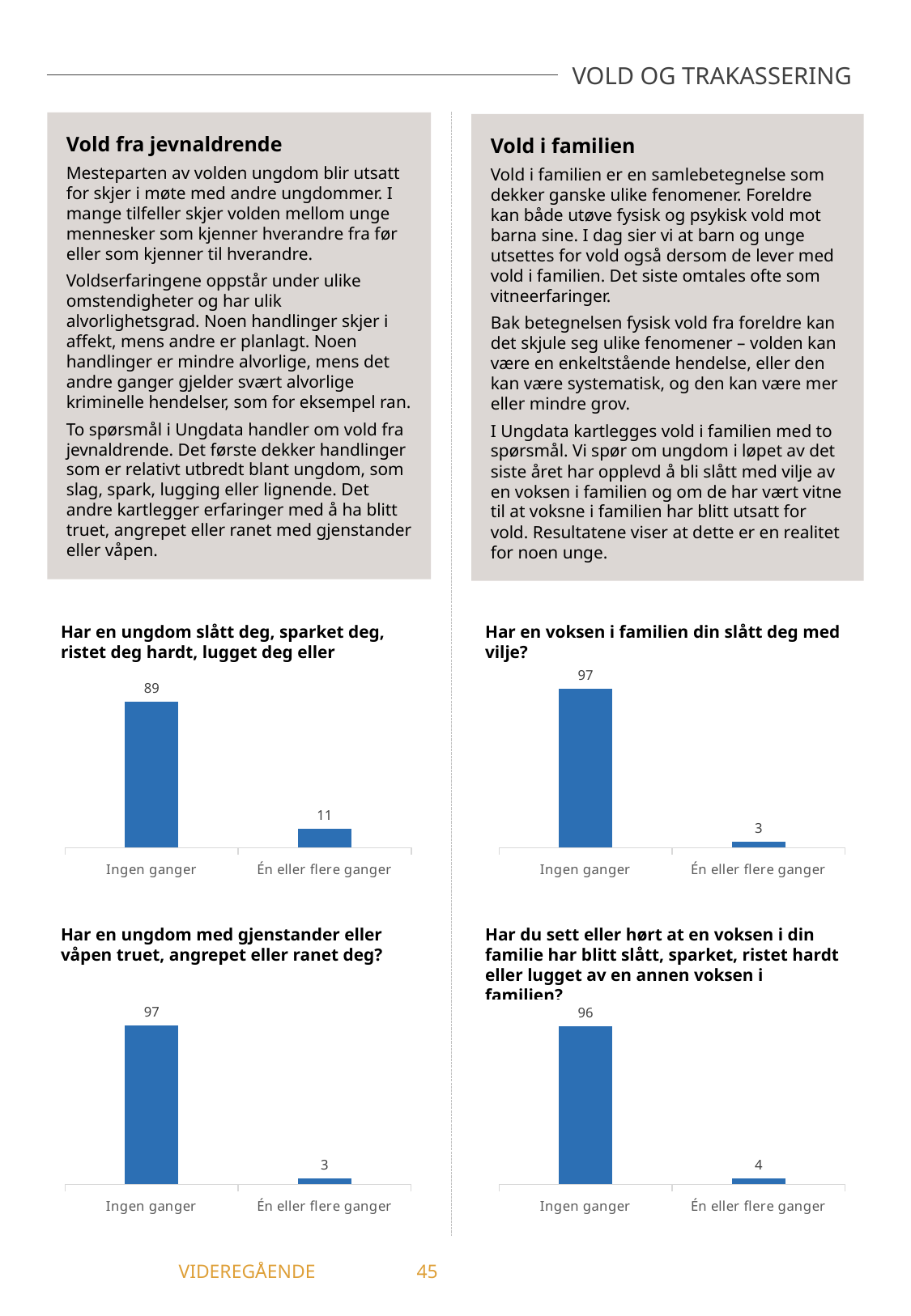
In the top-right chart ("Har en voksen i familien din slått deg med vilje?"), which category has the lowest value? Én eller flere ganger In the bottom-left chart ("Har en ungdom med gjenstander eller våpen truet, angrepet eller ranet deg?"), which category has the highest value? Ingen ganger In the top-right chart ("Har en voksen i familien din slått deg med vilje?"), what is the value for "Ingen ganger"? 97 In the top-left chart ("Har en ungdom slått deg, sparket deg..."), what is the value for "Én eller flere ganger"? 11 In the bottom-right chart ("Har du sett eller hørt at en voksen i din familie har blitt slått..."), what is the value for "Ingen ganger"? 96 In the top-left chart ("Har en ungdom slått deg, sparket deg..."), what is the difference between the values for "Ingen ganger" and "Én eller flere ganger"? 78 What type of chart is the top-left chart ("Har en ungdom slått deg, sparket deg...")? Bar chart In the bottom-right chart ("Har du sett eller hørt at en voksen i din familie har blitt slått..."), what is the value for "Én eller flere ganger"? 4 In the top-left chart ("Har en ungdom slått deg, sparket deg..."), what is the value for "Ingen ganger"? 89 In the top-right chart ("Har en voksen i familien din slått deg med vilje?"), what is the value for "Én eller flere ganger"? 3 In the bottom-left chart ("Har en ungdom med gjenstander eller våpen truet, angrepet eller ranet deg?"), what is the value for "Én eller flere ganger"? 3 How many categories are shown in the bottom-right chart ("Har du sett eller hørt at en voksen i din familie har blitt slått...")? 2